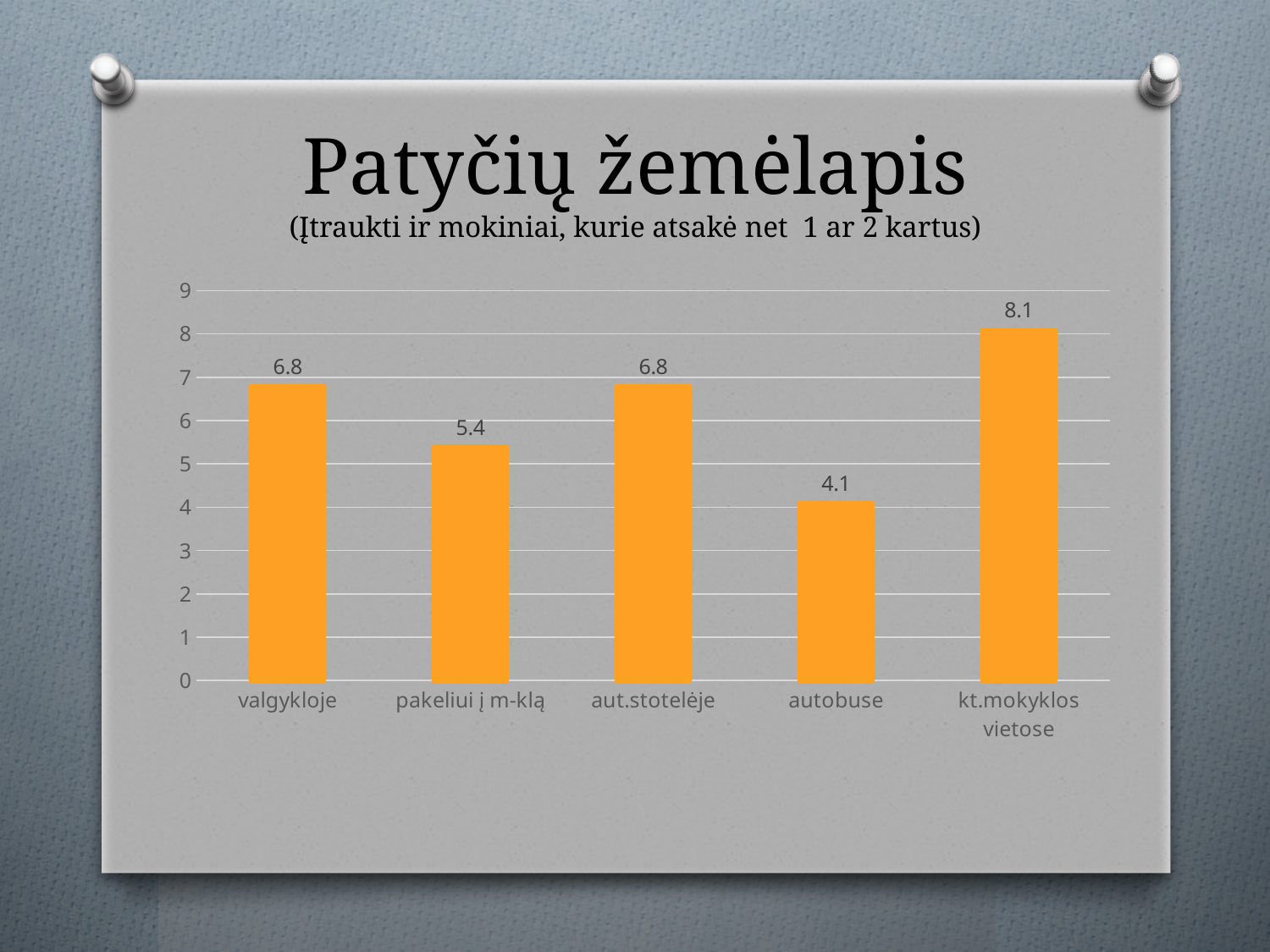
Which is larger, the value for pakeliui į m-klą or the value for aut.stotelėje? aut.stotelėje What is the title of the slide containing the chart? Patyčių žemėlapis What is the value for valgykloje? 6.8 What is the value for kt.mokyklos vietose? 8.1 What kind of chart is shown on the slide? bar chart How many categories are shown on the x axis? 5 Which category has the highest value? kt.mokyklos vietose What is the value for autobuse? 4.1 What is the difference between the values for valgykloje and pakeliui į m-klą? 1.4 What is the value for pakeliui į m-klą? 5.4 Which category has the lowest value? autobuse What is the difference between the values for kt.mokyklos vietose and autobuse? 4